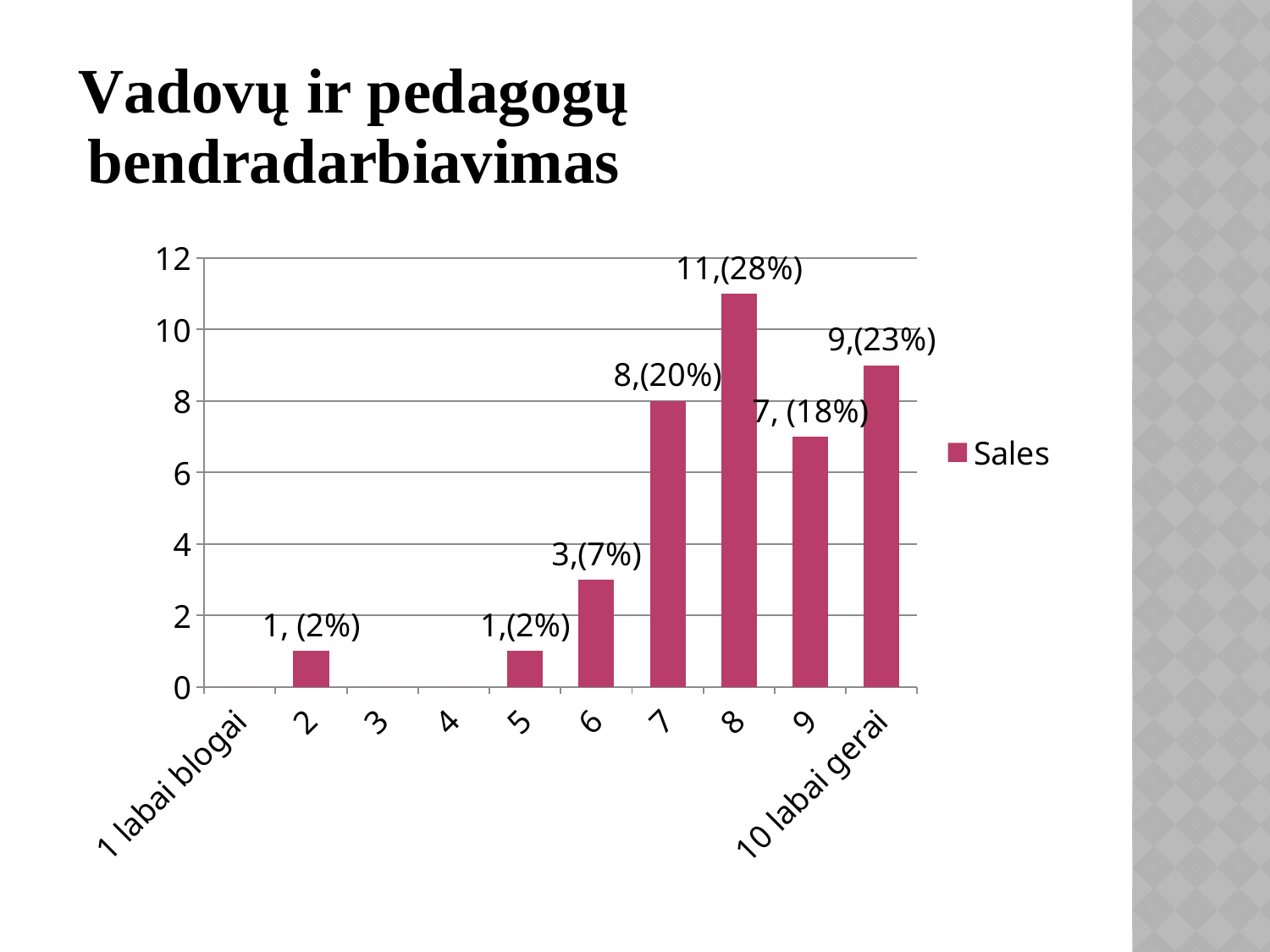
Which is larger, the count for category 7 or the count for '10 labai gerai'? 10 labai gerai Is the value for category 9 greater or less than 6? greater What is the name of the series in the legend? Sales What is the data label shown for category 7? 8,(20%) What is the data label shown for category 6? 3,(7%) What is the difference between the count for category 8 and the count for category 9? 4 How many categories are shown on the x axis? 10 Which category has the highest bar? 8 How many series does the legend list? 1 What is the data label shown for category 8? 11,(28%) What kind of chart is shown on the slide? bar chart What is the data label shown for the category '10 labai gerai'? 9,(23%)